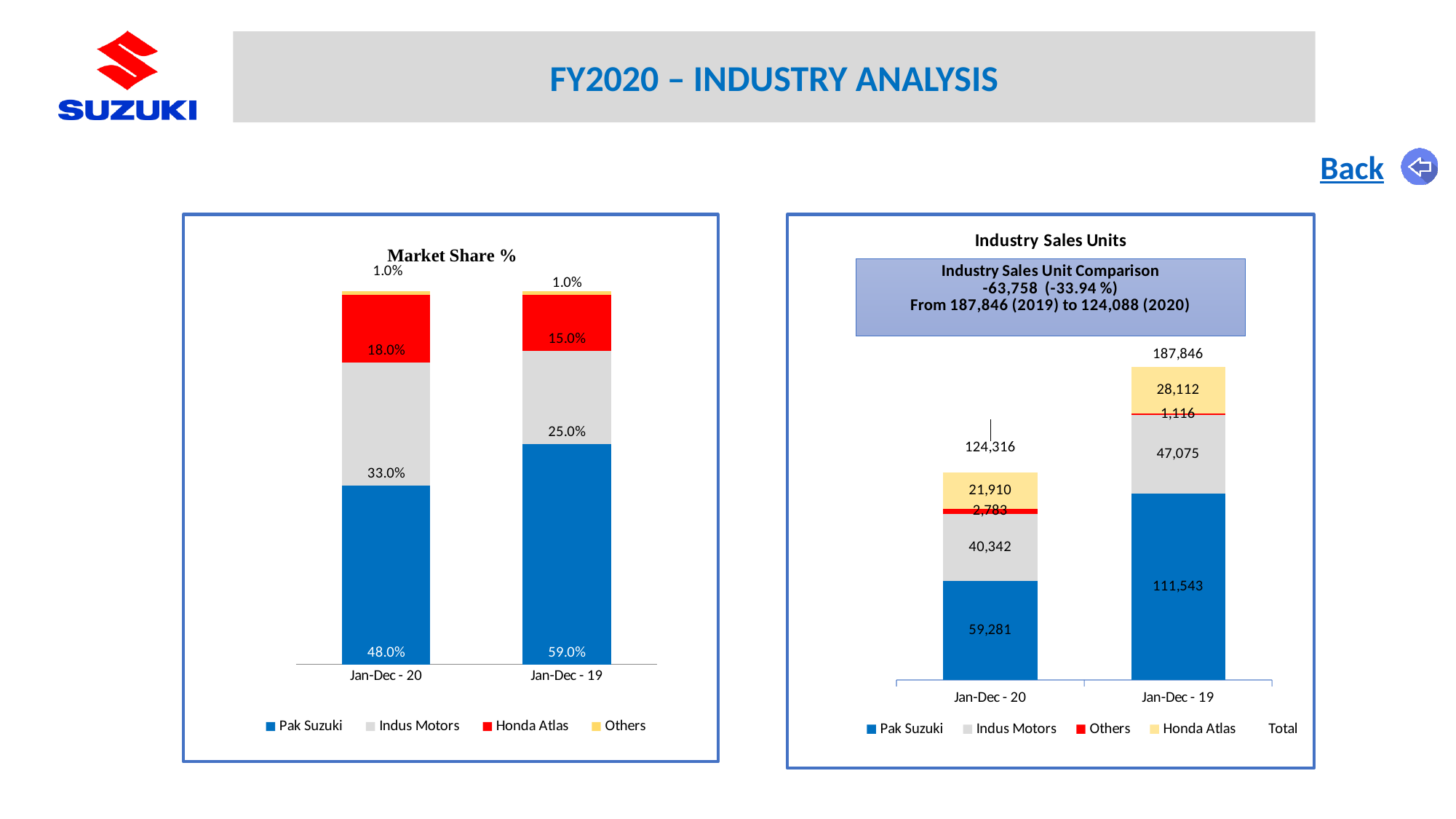
In the Market Share % chart, which company has the largest share in Jan-Dec - 20? Pak Suzuki In the Market Share % chart, what is Pak Suzuki's share for Jan-Dec - 20? 48.0% In the Market Share % chart, by how many percentage points did Pak Suzuki's share fall from Jan-Dec - 19 to Jan-Dec - 20? 11.0% In the Industry Sales Units chart, how many units did Indus Motors sell in Jan-Dec - 20? 40,342 What kind of chart is the Market Share % chart? Stacked bar chart How many entries does the legend of the Industry Sales Units chart list? 5 In the Market Share % chart, what is Honda Atlas's share for Jan-Dec - 19? 15.0% In the Industry Sales Units chart, were Honda Atlas's sales higher in Jan-Dec - 20 or Jan-Dec - 19? Jan-Dec - 19 In the Industry Sales Units chart, what is the difference between Pak Suzuki's sales in Jan-Dec - 19 and Jan-Dec - 20? 52,262 In the Industry Sales Units chart, what is the total shown above the Jan-Dec - 19 bar? 187,846 How many series does the legend of the Market Share % chart list? 4 In the Industry Sales Units chart, how many units did Pak Suzuki sell in Jan-Dec - 19? 111,543